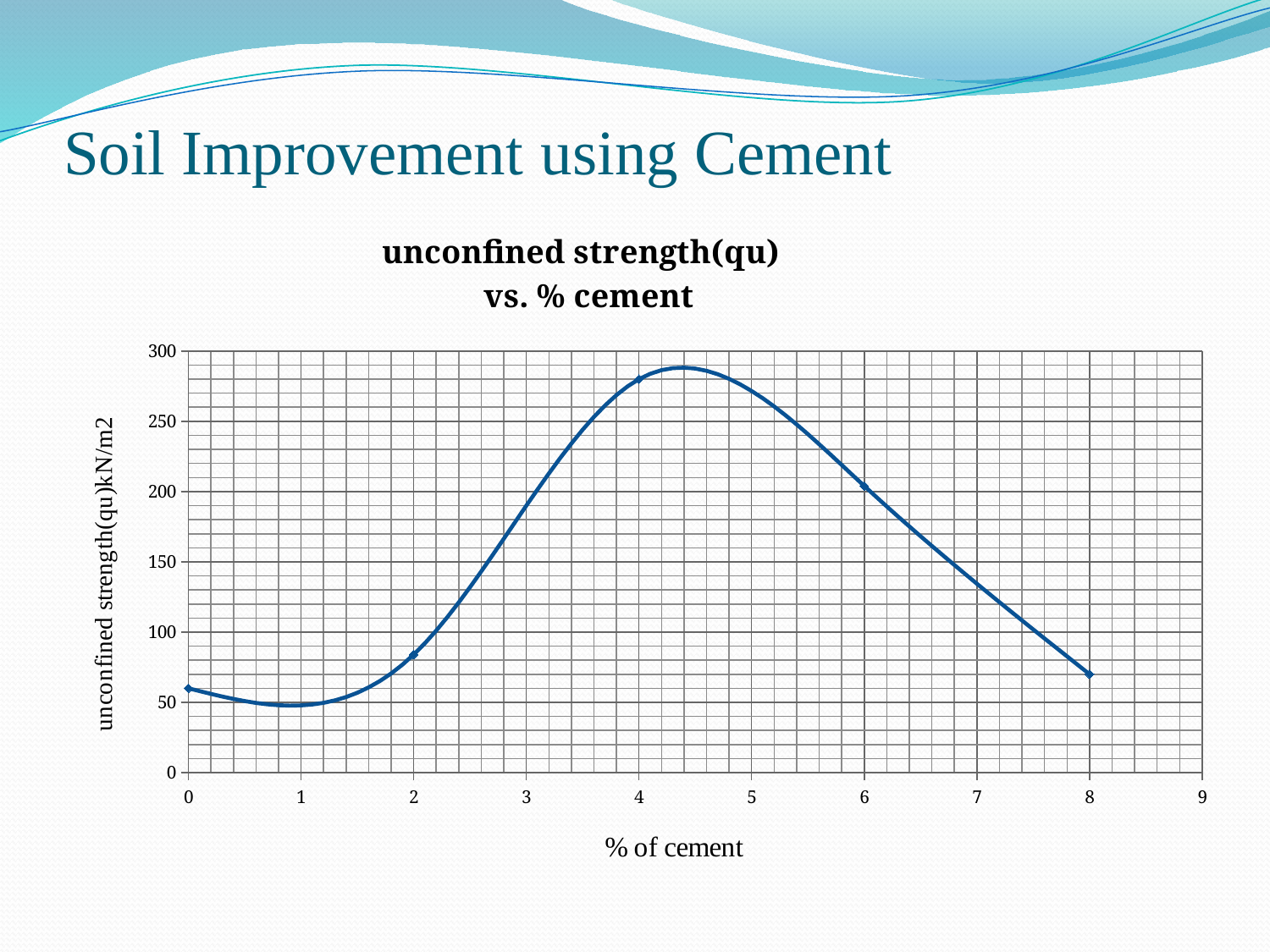
Is the unconfined strength at 4% cement greater or less than 250? greater Is the unconfined strength at 2% cement greater or less than 100? less What is the title of the chart? unconfined strength(qu) vs. % cement Is the unconfined strength at 6% cement greater or less than 150? greater At which % of cement is the unconfined strength highest? 4 How many data points are plotted on the line? 5 What is the label of the x axis? % of cement Which has the higher unconfined strength, 4% cement or 6% cement? 4% cement What kind of chart is shown on the slide? line chart Between 2% and 4% cement, does the unconfined strength rise or fall? rise Between 4% and 8% cement, does the unconfined strength rise or fall? fall